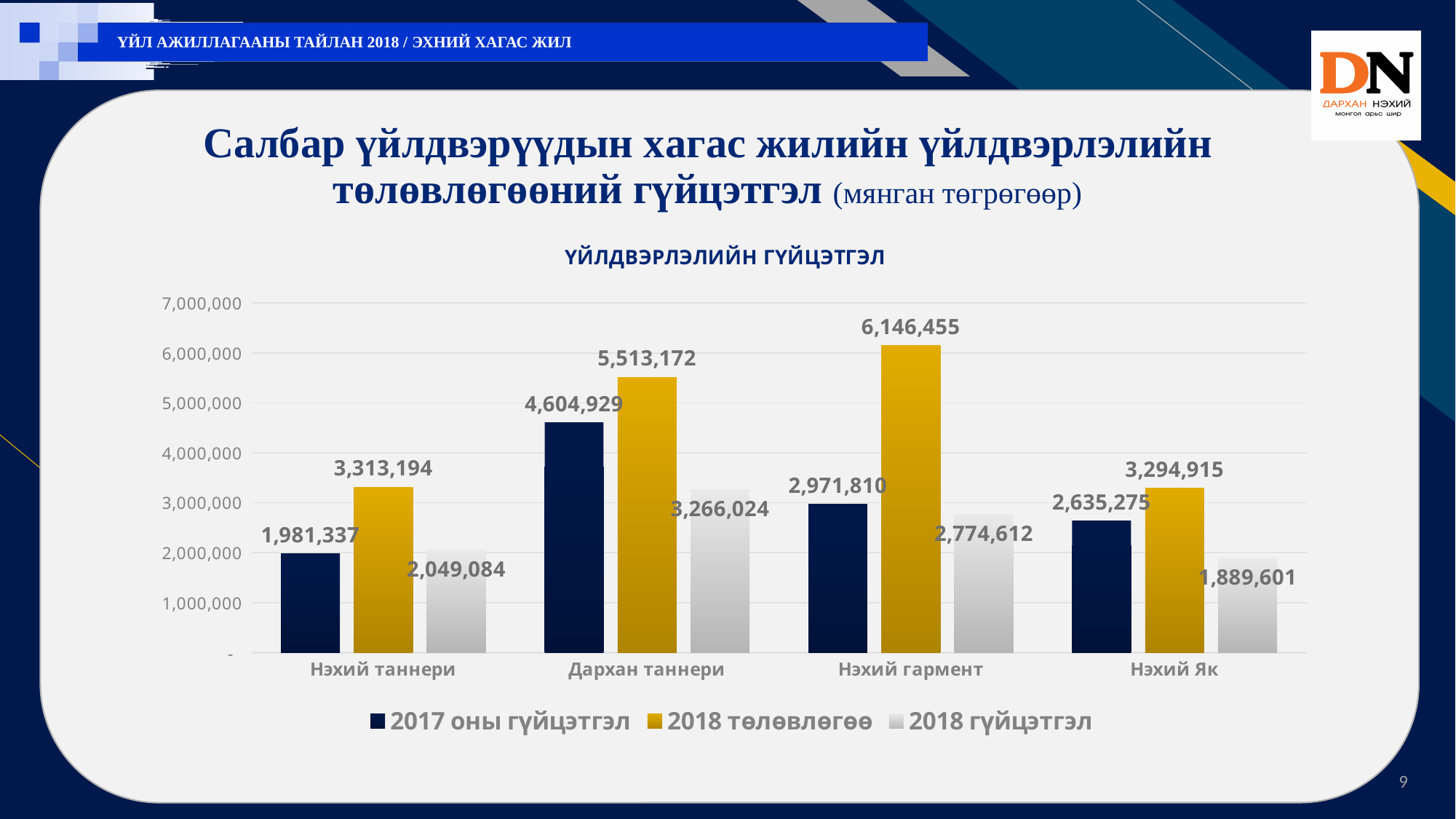
What is the 2018 төлөвлөгөө value for Нэхий гармент? 6,146,455 What is the difference between the 2018 төлөвлөгөө and 2017 оны гүйцэтгэл values for Дархан таннери? 908,243 Which category has the lowest 2018 гүйцэтгэл value? Нэхий Як Which is larger for Нэхий таннери: the 2017 оны гүйцэтгэл value or the 2018 гүйцэтгэл value? 2018 гүйцэтгэл Which category has the highest 2018 төлөвлөгөө value? Нэхий гармент How many series does the legend list? 3 What is the 2018 гүйцэтгэл value for Нэхий Як? 1,889,601 How many categories are shown on the x axis? 4 What is the difference between the 2018 төлөвлөгөө and 2018 гүйцэтгэл values for Нэхий гармент? 3,371,843 What kind of chart is shown on the slide? bar chart Is the 2018 гүйцэтгэл value for Дархан таннери greater or less than 3,000,000? greater What is the 2017 оны гүйцэтгэл value for Дархан таннери? 4,604,929